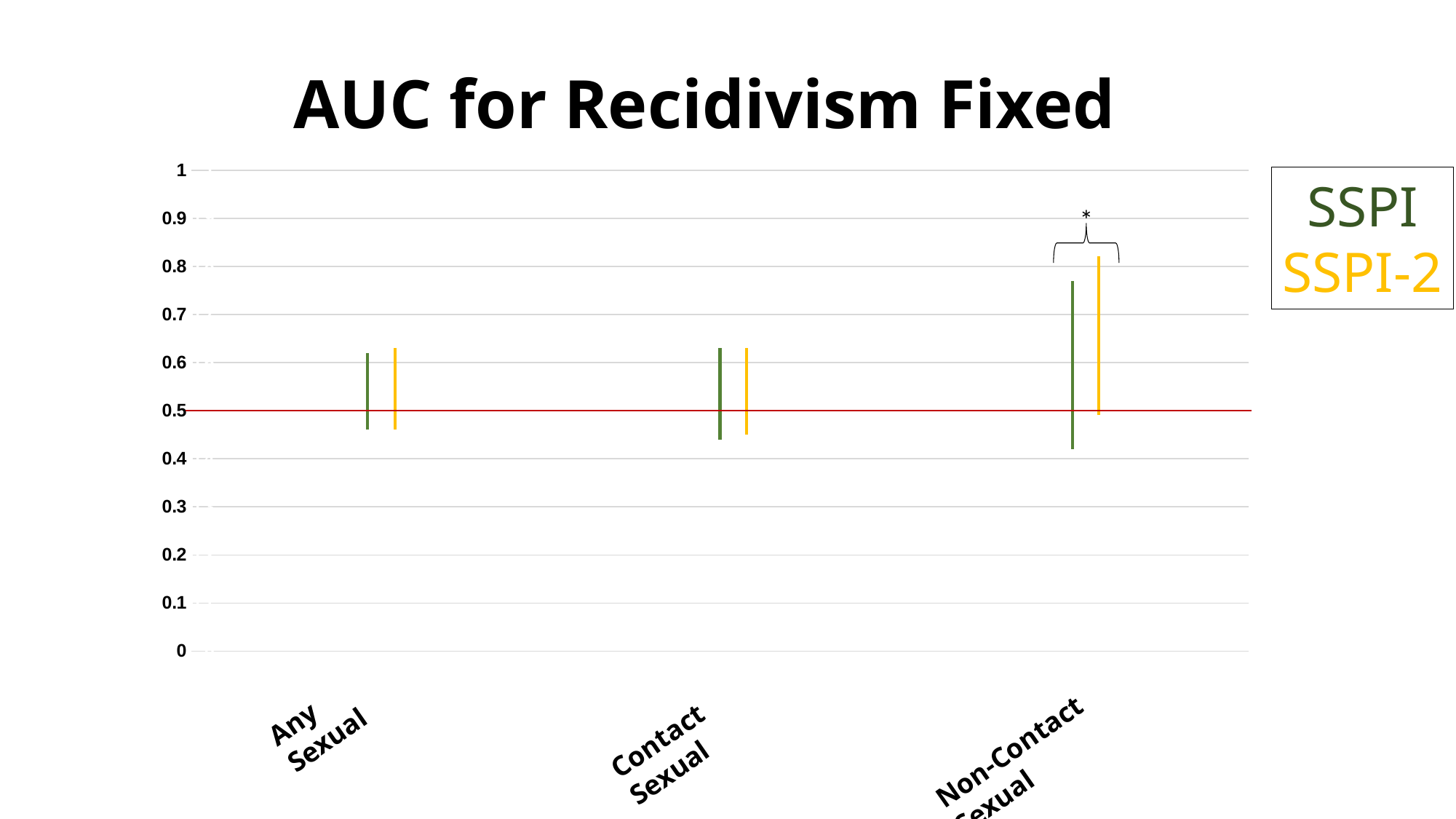
What are the two series named in the legend? SSPI and SSPI-2 What is the title of the chart? AUC for Recidivism Fixed Is the top of the SSPI-2 interval for Non-Contact Sexual greater or less than 0.7? greater For Non-Contact Sexual, which series reaches the higher upper value, SSPI or SSPI-2? SSPI-2 How many recidivism categories are shown on the x axis? 3 Is the bottom of the SSPI interval for Non-Contact Sexual greater or less than 0.5? less Is the top of the SSPI interval for Contact Sexual greater or less than 0.7? less How many series does the legend list? 2 Which category has the highest upper interval value? Non-Contact Sexual Which category is marked with an asterisk above its intervals? Non-Contact Sexual